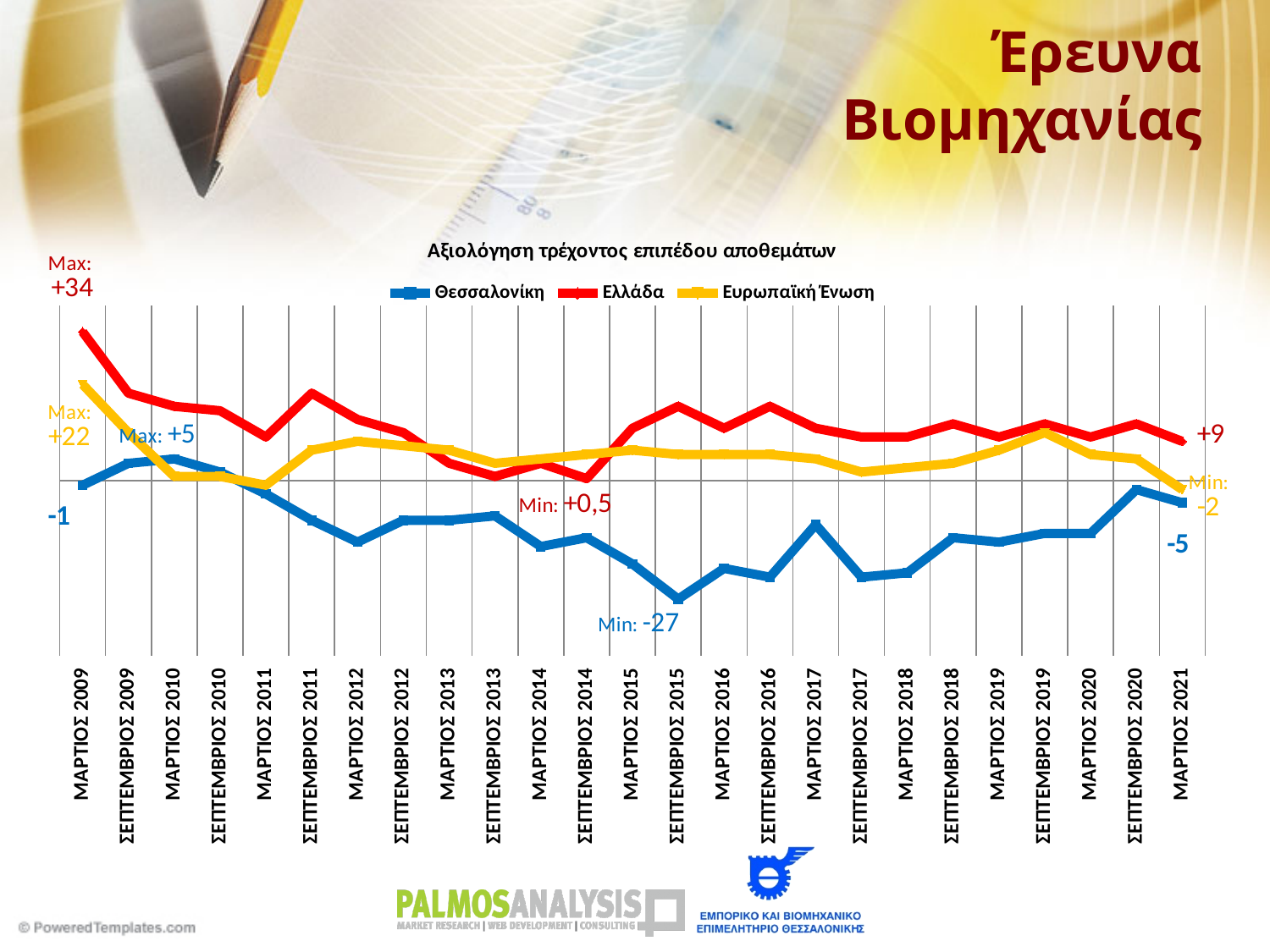
What is the maximum value reached by the Ευρωπαϊκή Ένωση series? +22 What is the minimum value reached by the Ελλάδα series? +0,5 What is the value for Ευρωπαϊκή Ένωση in ΜΑΡΤΙΟΣ 2021? -2 How many series does the legend list? 3 What is the value for Ελλάδα in ΜΑΡΤΙΟΣ 2021? +9 In ΜΑΡΤΙΟΣ 2021, what is the difference between the Ελλάδα value and the Θεσσαλονίκη value? 14 How many time points are shown on the x axis? 25 What kind of chart is shown on the slide? line chart What is the value for Θεσσαλονίκη in ΜΑΡΤΙΟΣ 2009? -1 What is the value for Θεσσαλονίκη in ΜΑΡΤΙΟΣ 2021? -5 What is the maximum value reached by the Ελλάδα series? +34 What is the minimum value reached by the Θεσσαλονίκη series? -27